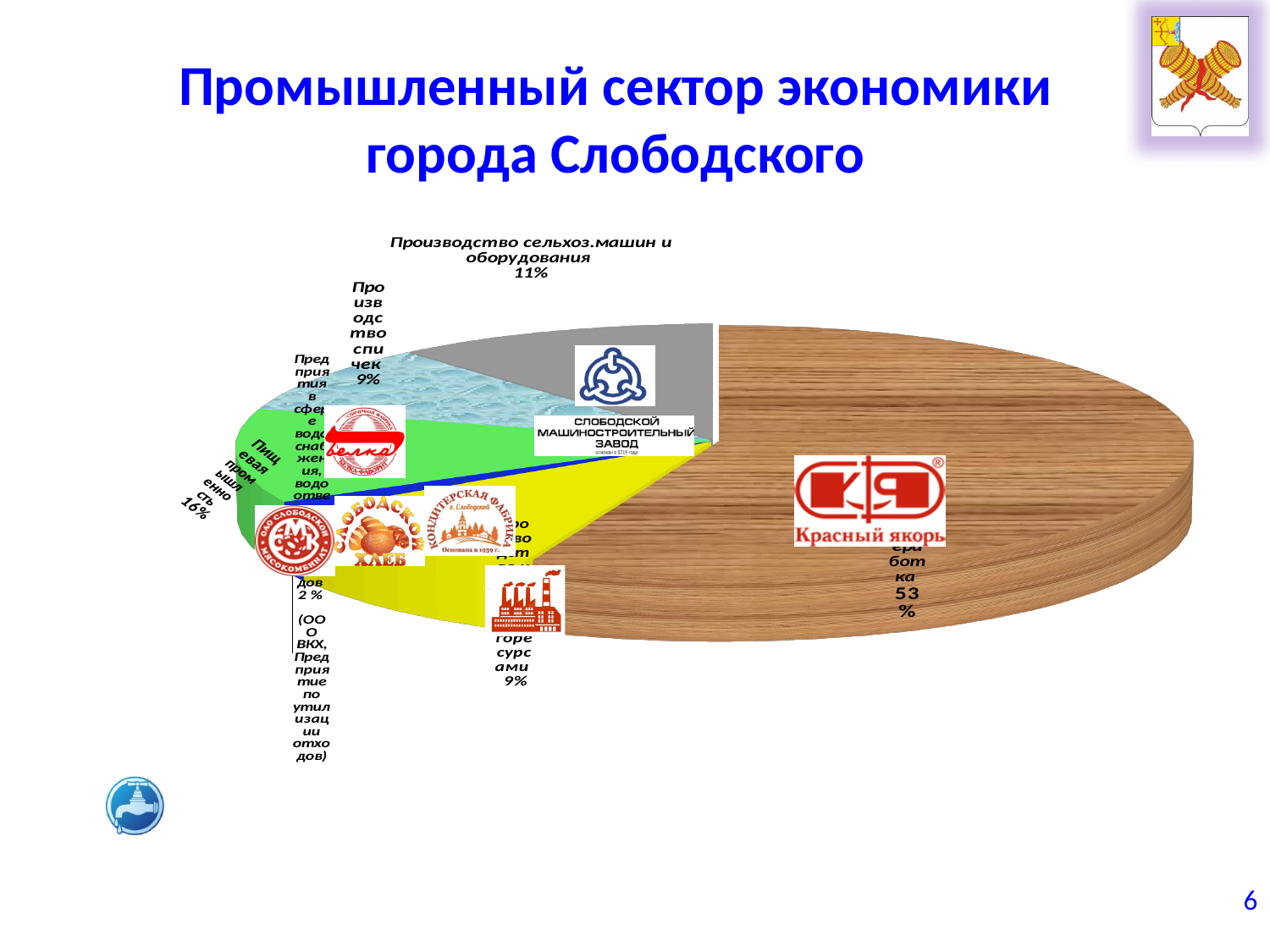
What percentage is shown for the smallest slice of the pie? 2% By how many percentage points does "Производство сельхоз.машин и оборудования" exceed "Производство спичек"? 2 percentage points Which has a larger share: "Пищевая промышленность" or "Производство спичек"? Пищевая промышленность What share of the pie does "Пищевая промышленность" have? 16% What share of the pie does "Производство сельхоз.машин и оборудования" have? 11% By how many percentage points does "Пищевая промышленность" exceed "Производство сельхоз.машин и оборудования"? 5 percentage points What percentage is shown for the largest slice of the pie? 53% What share of the pie does "Производство спичек" have? 9% Which has a larger share: "Производство сельхоз.машин и оборудования" or "Производство спичек"? Производство сельхоз.машин и оборудования What is the title of the slide containing the pie chart? Промышленный сектор экономики города Слободского What kind of chart is shown on the slide? Pie chart How many slices does the pie chart have? 6